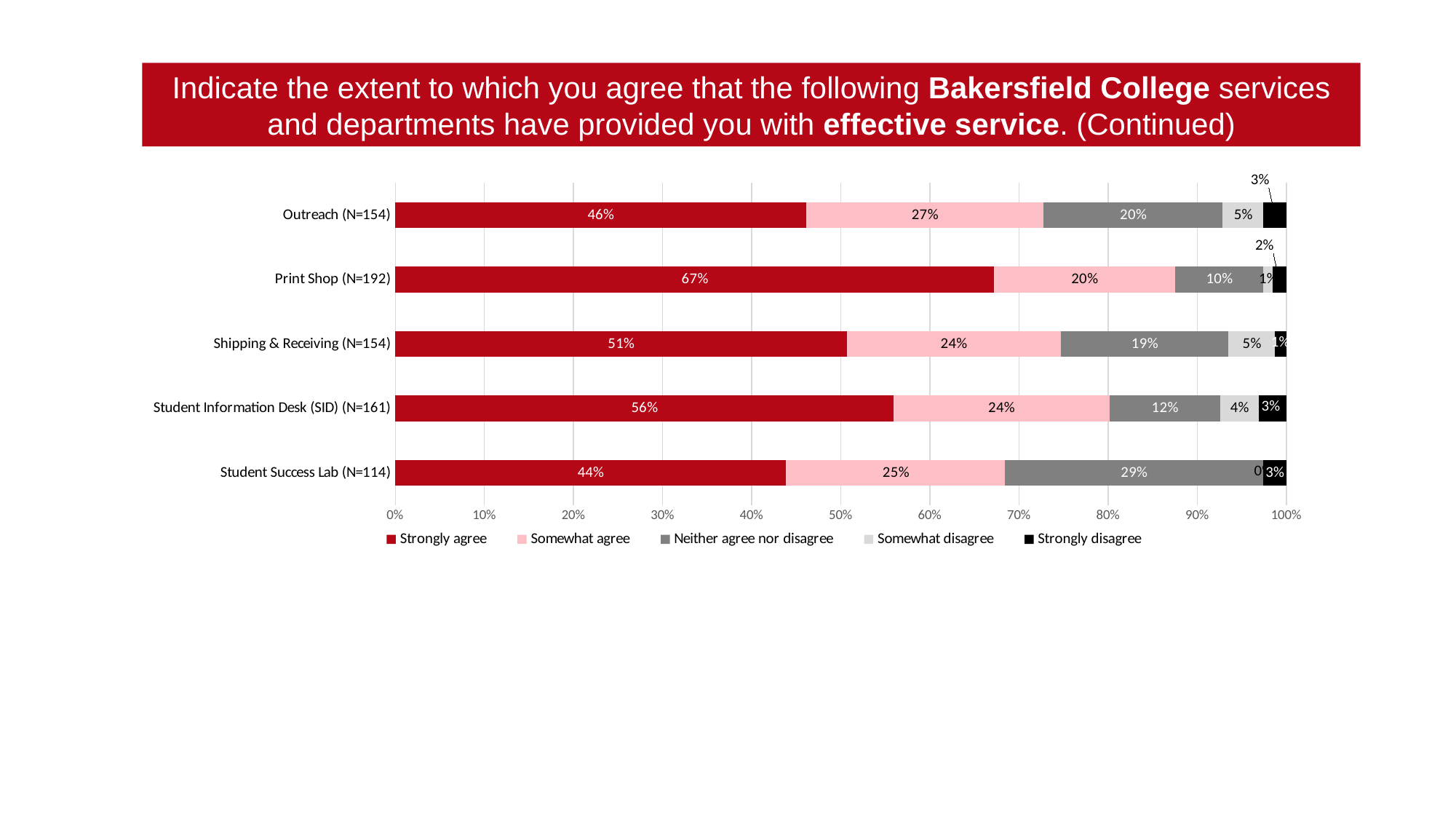
What is the difference between the Strongly agree values for Print Shop and Outreach? 21 percentage points What is the Somewhat agree value for Outreach (N=154)? 27% Which has a larger Neither agree nor disagree share, Outreach or Student Information Desk (SID)? Outreach (N=154) Which legend entry is shown in black? Strongly disagree What is the Neither agree nor disagree value for Student Success Lab (N=114)? 29% How many series does the legend list? 5 How many services are shown in the chart? 5 Which service has the highest Strongly agree percentage? Print Shop (N=192) What type of chart is shown on the slide? Stacked bar chart Which service has the lowest Strongly agree percentage? Student Success Lab (N=114) What is the Somewhat disagree value for Student Information Desk (SID) (N=161)? 4% What percentage of Print Shop respondents strongly agree that it provided effective service? 67%